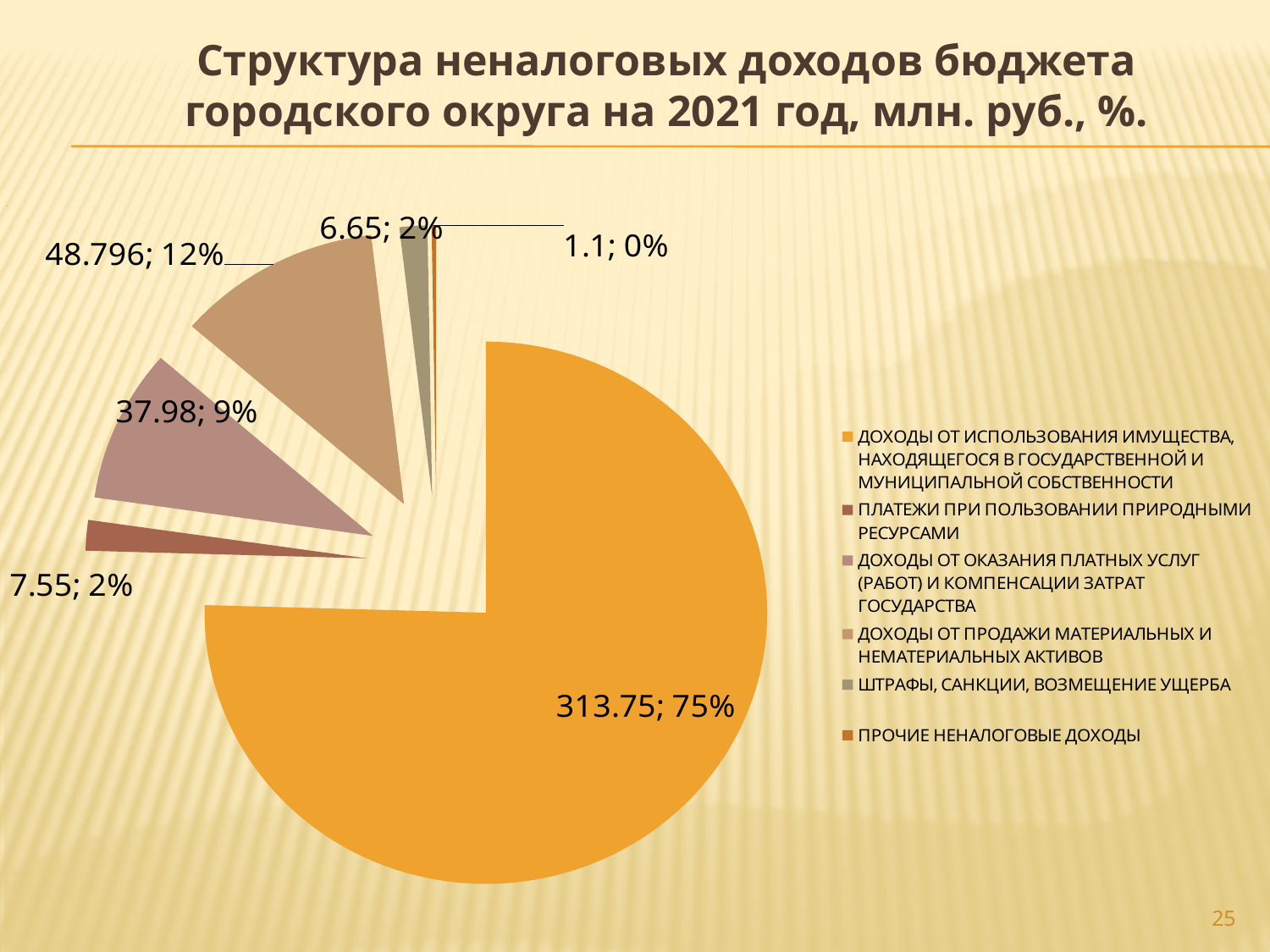
What is the difference in million rubles between ДОХОДЫ ОТ ПРОДАЖИ МАТЕРИАЛЬНЫХ И НЕМАТЕРИАЛЬНЫХ АКТИВОВ and ДОХОДЫ ОТ ОКАЗАНИЯ ПЛАТНЫХ УСЛУГ (РАБОТ) И КОМПЕНСАЦИИ ЗАТРАТ ГОСУДАРСТВА? 10.816 Which is larger: ПЛАТЕЖИ ПРИ ПОЛЬЗОВАНИИ ПРИРОДНЫМИ РЕСУРСАМИ or ШТРАФЫ, САНКЦИИ, ВОЗМЕЩЕНИЕ УЩЕРБА? ПЛАТЕЖИ ПРИ ПОЛЬЗОВАНИИ ПРИРОДНЫМИ РЕСУРСАМИ What type of chart is shown on the slide? Pie chart What share of the pie does ДОХОДЫ ОТ ОКАЗАНИЯ ПЛАТНЫХ УСЛУГ (РАБОТ) И КОМПЕНСАЦИИ ЗАТРАТ ГОСУДАРСТВА represent? 9% How many entries does the legend list? 6 What is the value (in million rubles) for ДОХОДЫ ОТ ПРОДАЖИ МАТЕРИАЛЬНЫХ И НЕМАТЕРИАЛЬНЫХ АКТИВОВ? 48.796 What share of the pie does ПРОЧИЕ НЕНАЛОГОВЫЕ ДОХОДЫ represent? 0% What is the value (in million rubles) for ДОХОДЫ ОТ ИСПОЛЬЗОВАНИЯ ИМУЩЕСТВА, НАХОДЯЩЕГОСЯ В ГОСУДАРСТВЕННОЙ И МУНИЦИПАЛЬНОЙ СОБСТВЕННОСТИ? 313.75 Which category has the smallest slice of the pie? ПРОЧИЕ НЕНАЛОГОВЫЕ ДОХОДЫ How many slices does the pie chart have? 6 What is the value (in million rubles) for ШТРАФЫ, САНКЦИИ, ВОЗМЕЩЕНИЕ УЩЕРБА? 6.65 Which category has the largest slice of the pie? ДОХОДЫ ОТ ИСПОЛЬЗОВАНИЯ ИМУЩЕСТВА, НАХОДЯЩЕГОСЯ В ГОСУДАРСТВЕННОЙ И МУНИЦИПАЛЬНОЙ СОБСТВЕННОСТИ